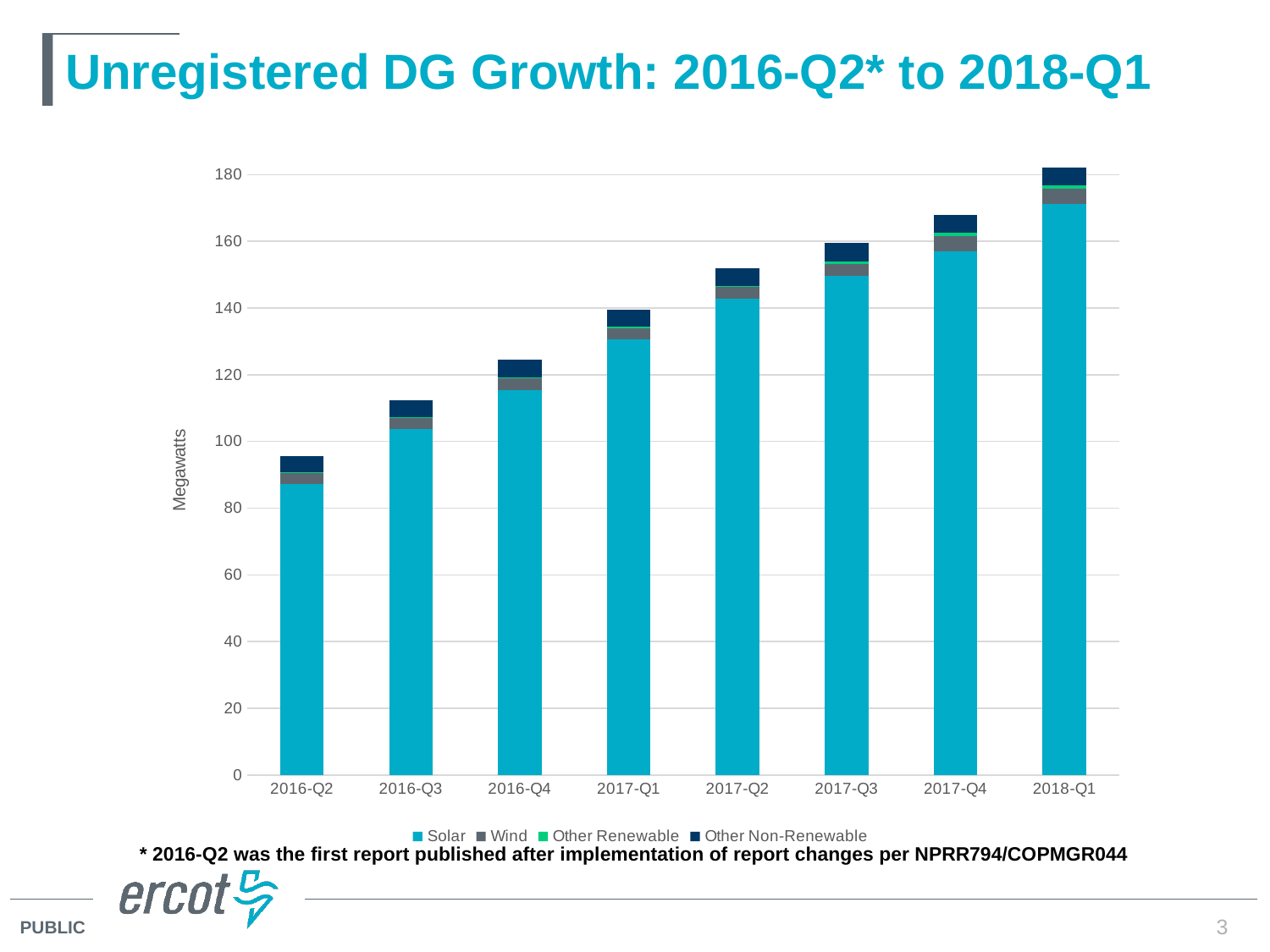
Which quarter has the lowest total unregistered DG capacity? 2016-Q2 Is the total value for 2017-Q2 greater or less than 140? greater Is the Solar value for 2018-Q1 greater or less than 160? greater What kind of chart is shown on the slide? Stacked bar chart Do the total bar heights rise or fall from 2016-Q2 to 2018-Q1? Rise How many series does the chart's legend list? 4 Which is larger, the total for 2017-Q4 or the total for 2016-Q3? 2017-Q4 How many quarters are shown along the x axis of the chart? 8 Is the total value for 2016-Q2 greater or less than 100? less Which quarter has the highest total unregistered DG capacity? 2018-Q1 What is the label on the y axis of the chart? Megawatts